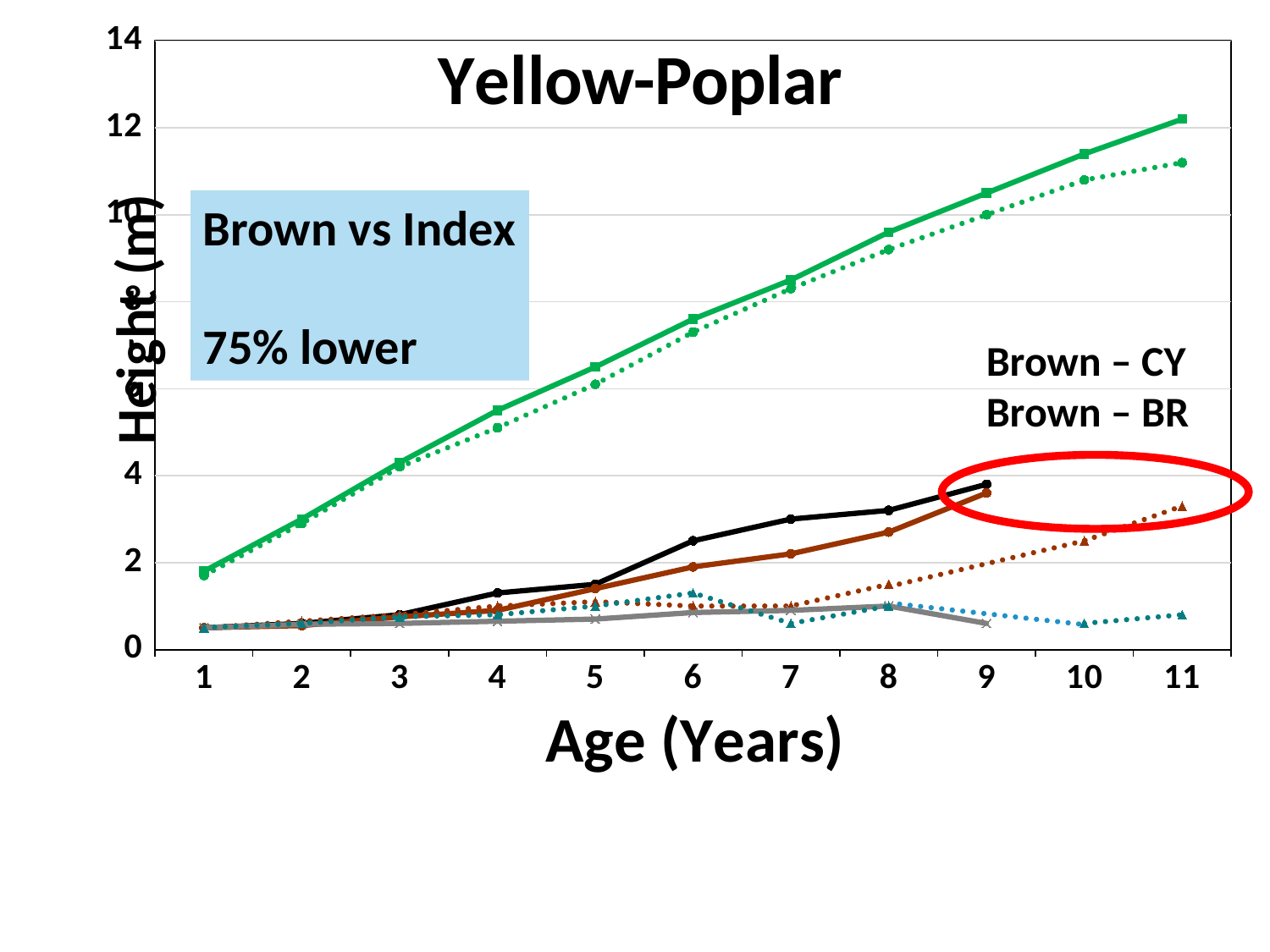
At which age does the solid green line reach its highest value? 11 At age 11, which is higher: the solid green line or the dotted green line? solid green line Does the solid green line rise or fall as age increases from 1 to 11? rise What is the label of the x axis? Age (Years) What is the title of the chart? Yellow-Poplar Is the value of the solid green line at age 11 greater or less than 10? greater Is the value of the solid black line at age 9 greater or less than 2? greater Is the value of the dotted green line at age 11 greater or less than 10? greater What kind of chart is shown on the slide? line chart How many age values are shown along the x axis? 11